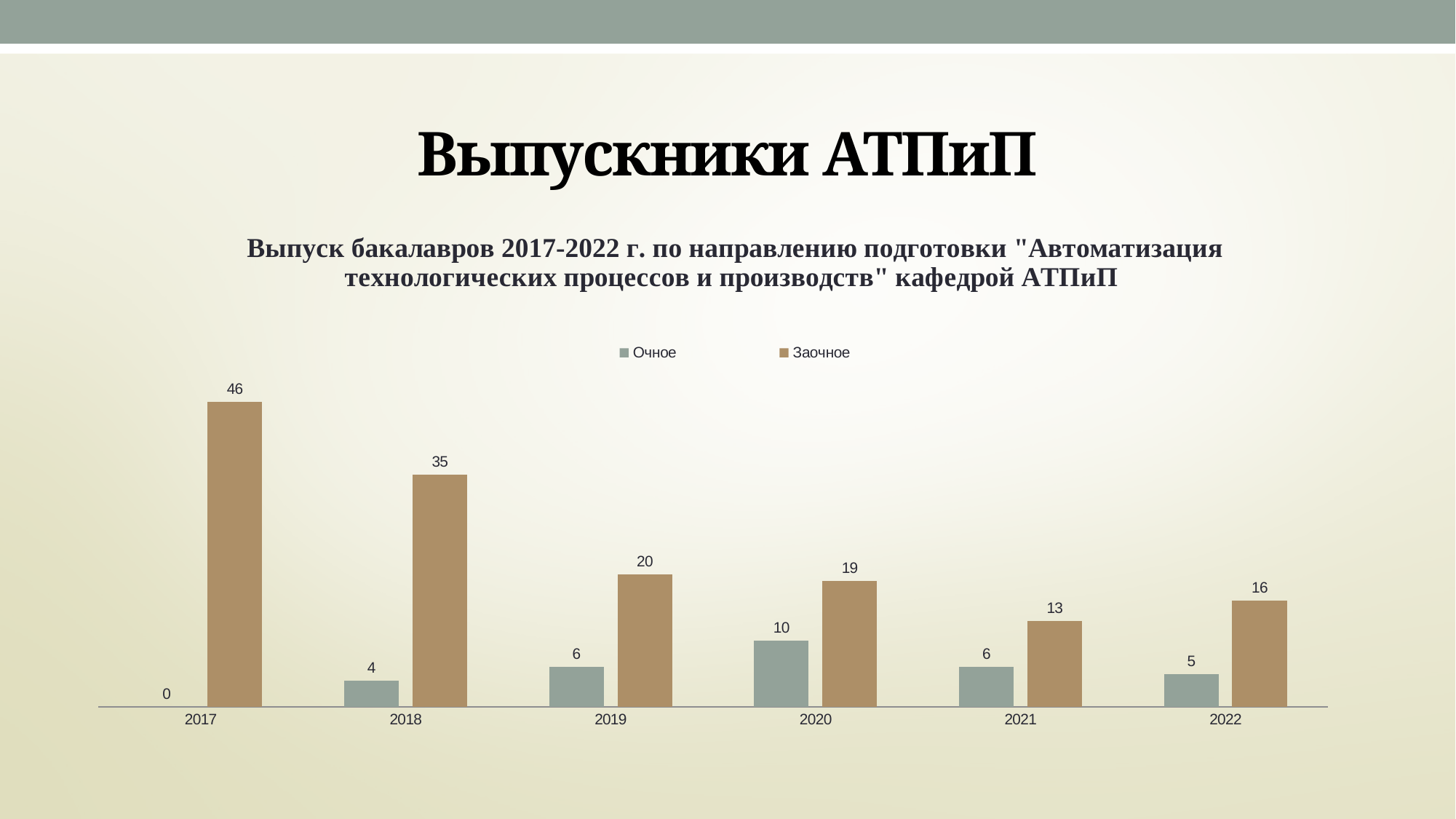
What is the value for Очное in 2020? 10 Which year has the lowest value for Очное? 2017 What is the value for Заочное in 2017? 46 Do the values for Заочное rise or fall from 2017 to 2021? Fall Which year has the highest value for Заочное? 2017 Which is larger in 2022, Очное or Заочное? Заочное What kind of chart is shown on the slide? Bar chart How many series does the legend list? 2 What is the value for Очное in 2017? 0 What is the difference between Заочное and Очное in 2019? 14 How many years are shown on the x axis? 6 Which series is shown in brown? Заочное